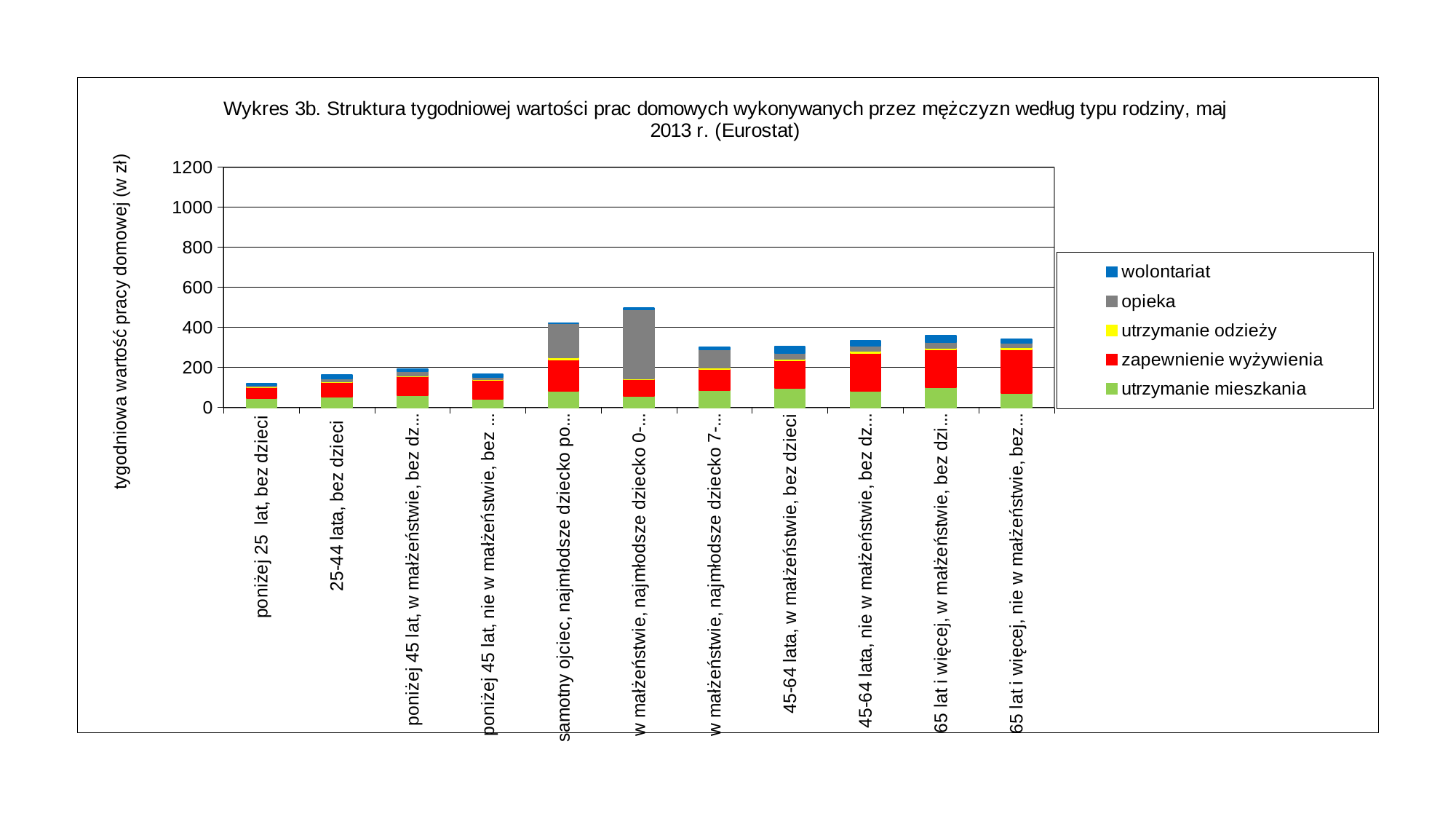
What is the label of the vertical axis? tygodniowa wartość pracy domowej (w zł) Is the total value for the bar labelled 'w małżeństwie, najmłodsze dziecko 0-...' greater or less than 400? greater Which category has the shortest stacked bar? poniżej 25 lat, bez dzieci How many series does the legend list? 5 Is the total value for 'samotny ojciec, najmłodsze dziecko po...' greater or less than 200? greater Which bar is taller: '25-44 lata, bez dzieci' or 'w małżeństwie, najmłodsze dziecko 7-...'? w małżeństwie, najmłodsze dziecko 7-... Which series is shown in grey in the legend? opieka Is the total value for 'poniżej 25 lat, bez dzieci' greater or less than 200? less Which category has the tallest stacked bar? w małżeństwie, najmłodsze dziecko 0-... Which bar is taller: 'samotny ojciec, najmłodsze dziecko po...' or '45-64 lata, w małżeństwie, bez dzieci'? samotny ojciec, najmłodsze dziecko po... How many family-type categories are plotted along the x axis? 11 What kind of chart is shown on the slide? Stacked bar chart